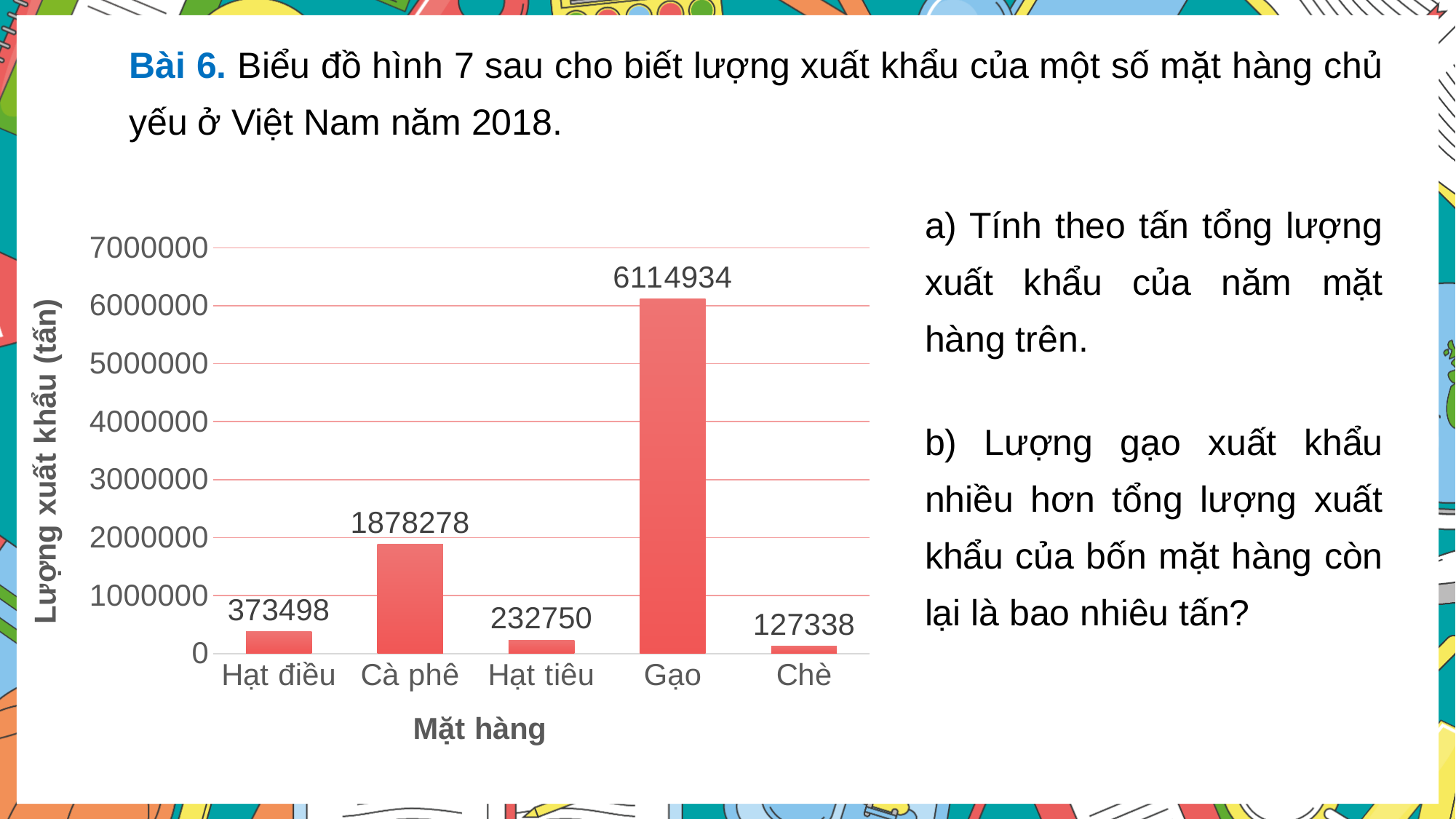
What is the export volume for Hạt tiêu? 232750 Is the value for Cà phê greater or less than 1000000? greater How many categories are shown on the x axis? 5 Which category has the highest export volume? Gạo What is the difference between the export volumes of Hạt điều and Hạt tiêu? 140748 What kind of chart is shown on the slide? Bar chart What is the export volume for Cà phê? 1878278 Which category has the lowest export volume? Chè What is the export volume for Gạo? 6114934 What is the difference between the export volumes of Gạo and Cà phê? 4236656 Which has a larger export volume, Hạt điều or Hạt tiêu? Hạt điều What is the export volume for Chè? 127338